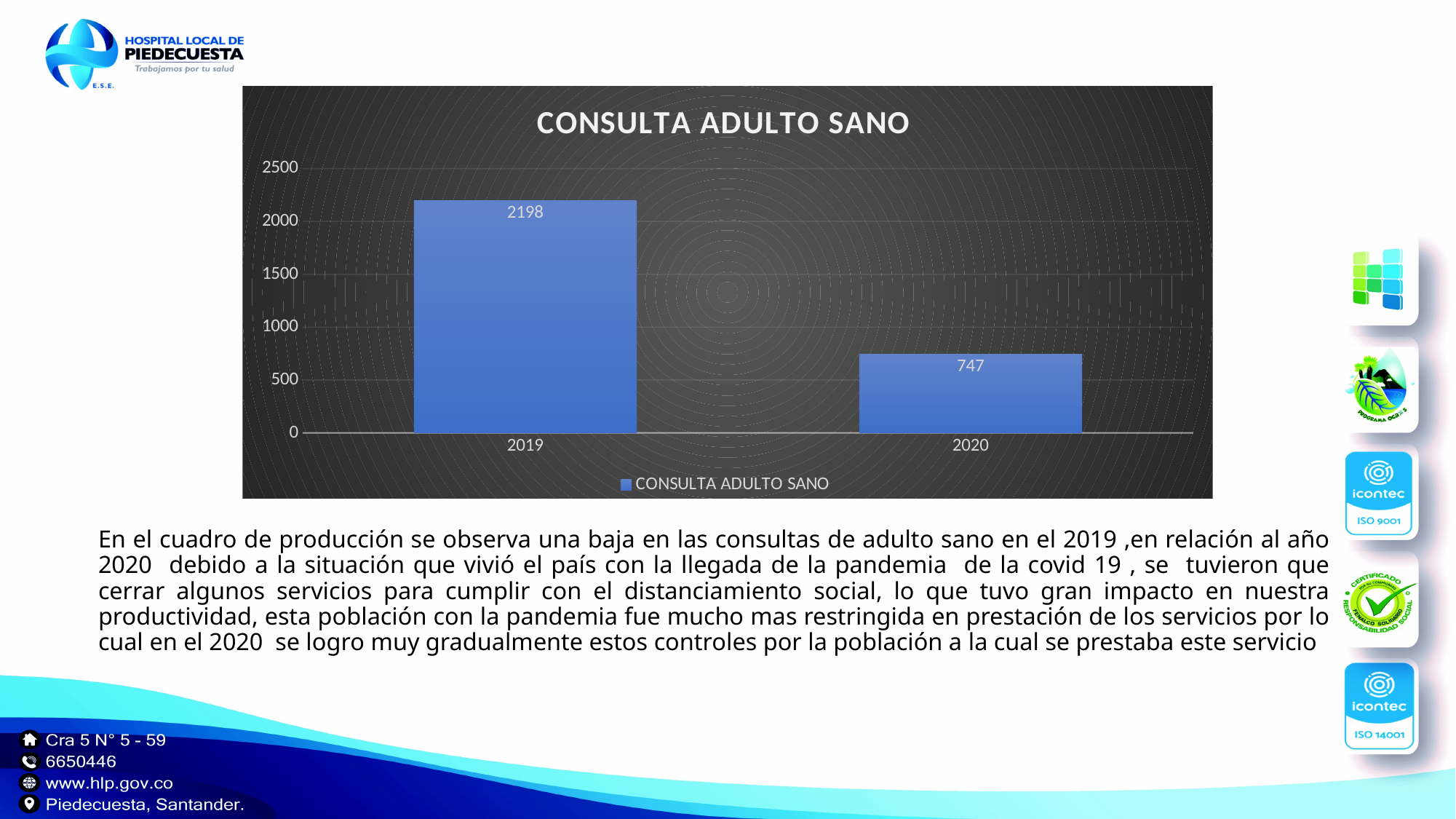
Which year has the highest value in the CONSULTA ADULTO SANO chart? 2019 Do the values rise or fall from 2019 to 2020 in the CONSULTA ADULTO SANO chart? Fall Is the value for 2020 in the CONSULTA ADULTO SANO chart greater or less than 1000? less Which year has the lowest value in the CONSULTA ADULTO SANO chart? 2020 Which is larger in the CONSULTA ADULTO SANO chart, the value for 2019 or the value for 2020? 2019 How many years are shown on the x axis of the CONSULTA ADULTO SANO chart? 2 What is the value for 2019 in the CONSULTA ADULTO SANO chart? 2198 What is the difference between the 2019 and 2020 values in the CONSULTA ADULTO SANO chart? 1451 What kind of chart is shown on the slide? Bar chart What is the value for 2020 in the CONSULTA ADULTO SANO chart? 747 How many series does the legend of the CONSULTA ADULTO SANO chart list? 1 Is the value for 2019 in the CONSULTA ADULTO SANO chart greater or less than 2000? greater